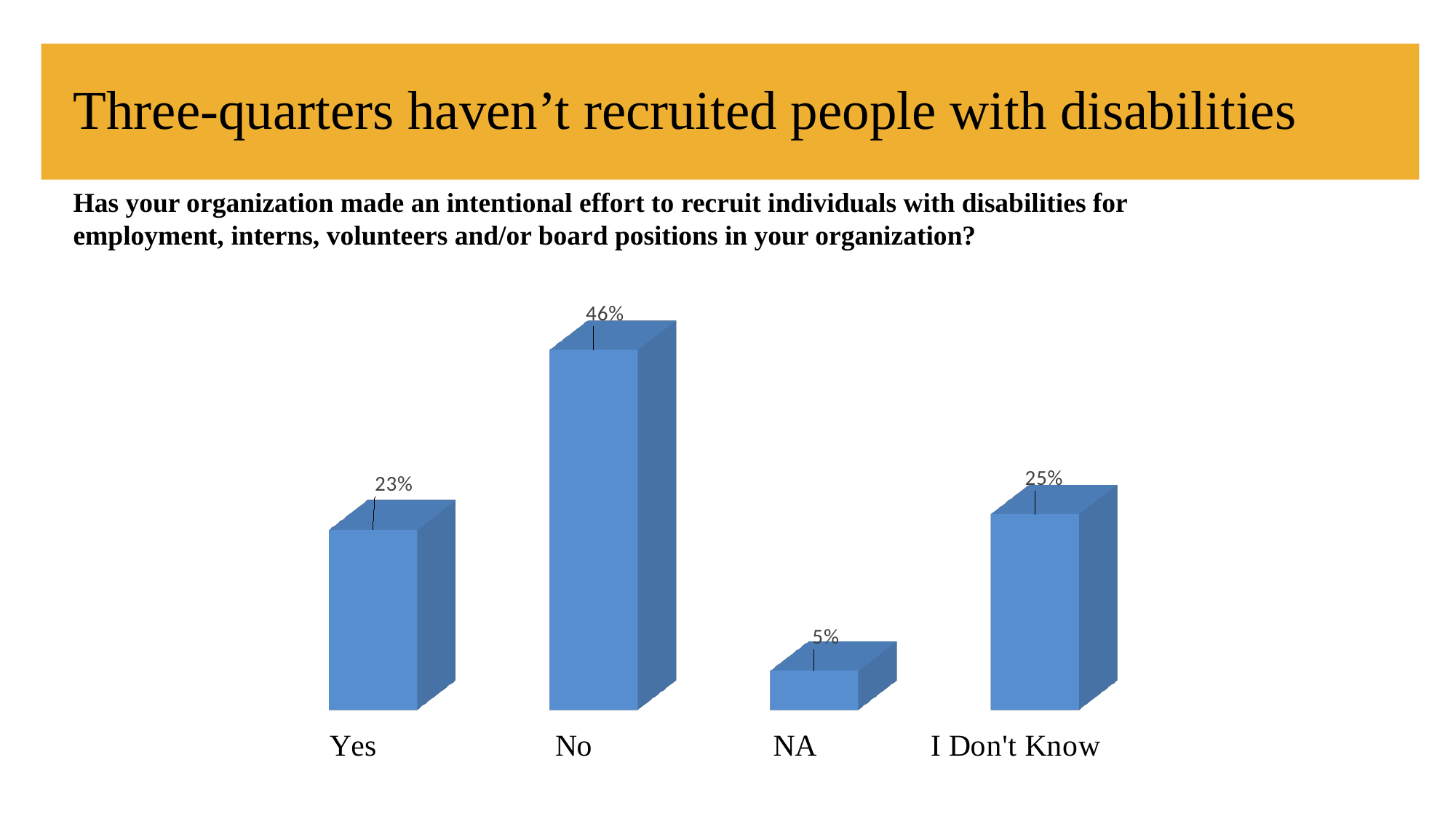
What percentage of respondents answered "Yes"? 23% Which is larger, the value for "Yes" or the value for "I Don't Know"? I Don't Know What is the difference between the "I Don't Know" and "NA" percentages? 20% What percentage of respondents answered "NA"? 5% What is the title of the slide containing the chart? Three-quarters haven't recruited people with disabilities Which response category has the highest value? No What is the difference between the "No" and "Yes" percentages? 23% What percentage of respondents answered "No"? 46% What kind of chart is shown on the slide? Bar chart What percentage of respondents answered "I Don't Know"? 25% How many response categories are shown in the chart? 4 Which response category has the lowest value? NA